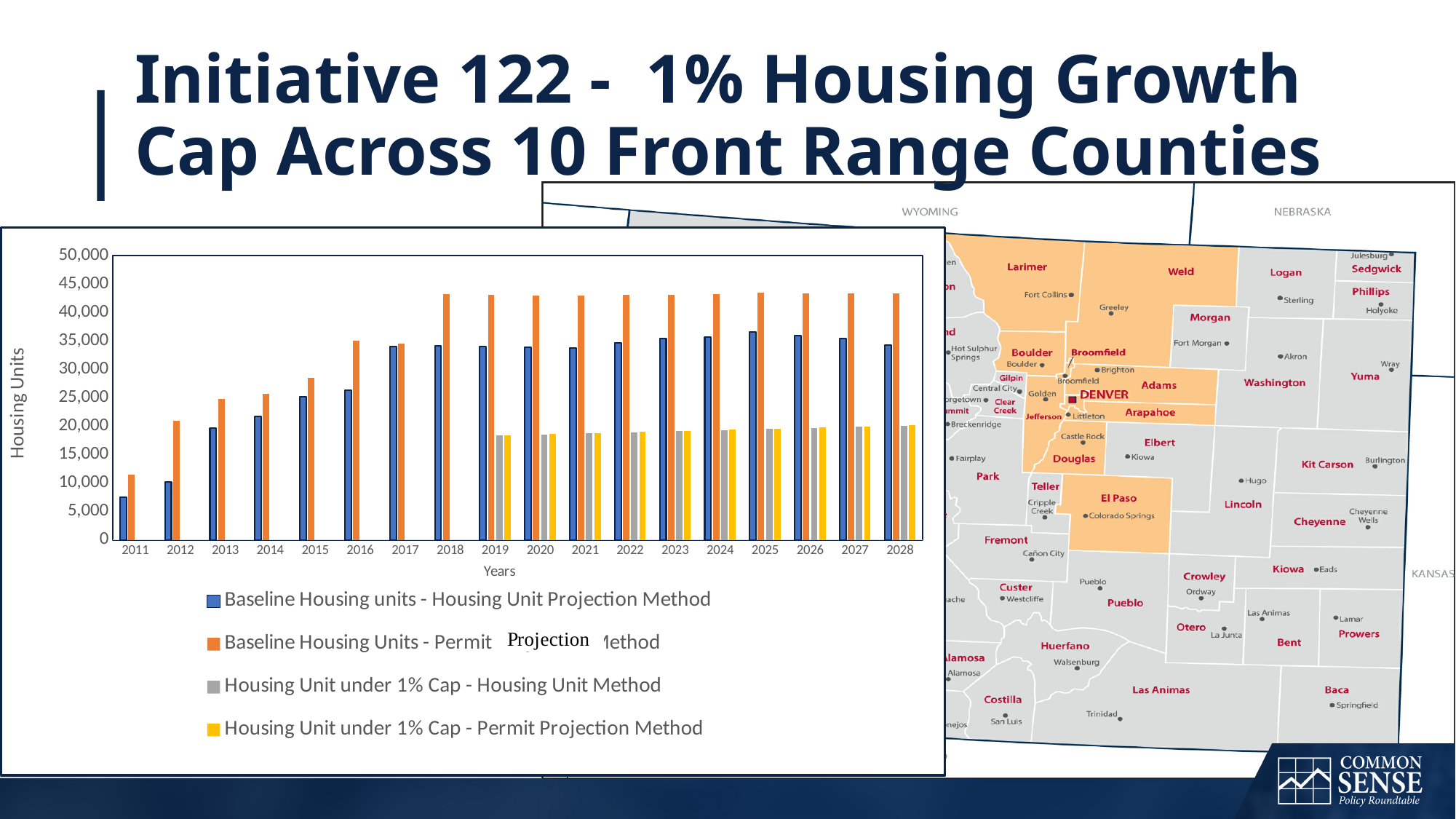
Is the value for Housing Unit under 1% Cap - Housing Unit Method in 2019 greater or less than 20,000? less Is the value for Baseline Housing Units - Permit Projection Method in 2018 greater or less than 40,000? greater Is the value for Baseline Housing Units - Permit Projection Method in 2011 greater or less than 10,000? greater Do the values for Baseline Housing units - Housing Unit Projection Method rise or fall from 2011 to 2018? rise What is the title of the y axis of the bar chart? Housing Units How many series does the legend of the bar chart list? 4 Which year has the lowest value for Baseline Housing units - Housing Unit Projection Method? 2011 In 2016, which is larger: Baseline Housing units - Housing Unit Projection Method or Baseline Housing Units - Permit Projection Method? Baseline Housing Units - Permit Projection Method In 2028, which is larger: Baseline Housing units - Housing Unit Projection Method or Housing Unit under 1% Cap - Housing Unit Method? Baseline Housing units - Housing Unit Projection Method How many years are shown along the x axis of the bar chart? 18 What kind of chart is shown on the left of the slide? bar chart